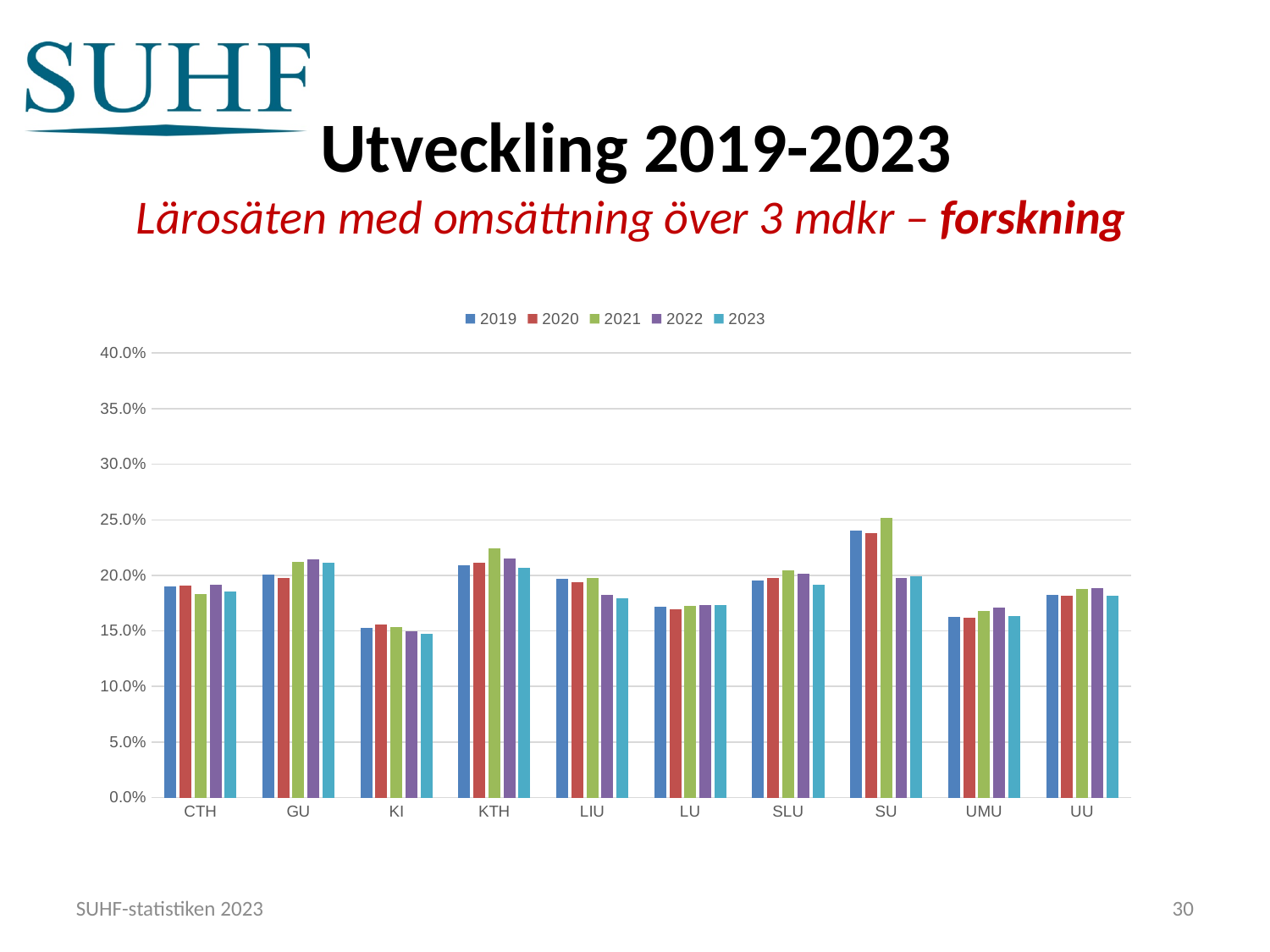
Which is larger, the 2019 value for SU or the 2019 value for UMU? SU Is the 2021 value for KTH greater or less than 20.0%? greater Which years are listed in the legend? 2019, 2020, 2021, 2022, 2023 Which university has the highest bar in the chart? SU Is the 2019 value for KI greater or less than 20.0%? less Which university has the lowest values overall in the chart? KI What kind of chart is shown on the slide? bar chart Is the 2019 value for SU greater or less than 20.0%? greater For SU, is the 2023 value higher or lower than the 2019 value? lower How many series does the legend list? 5 How many universities (categories) are shown on the x axis? 10